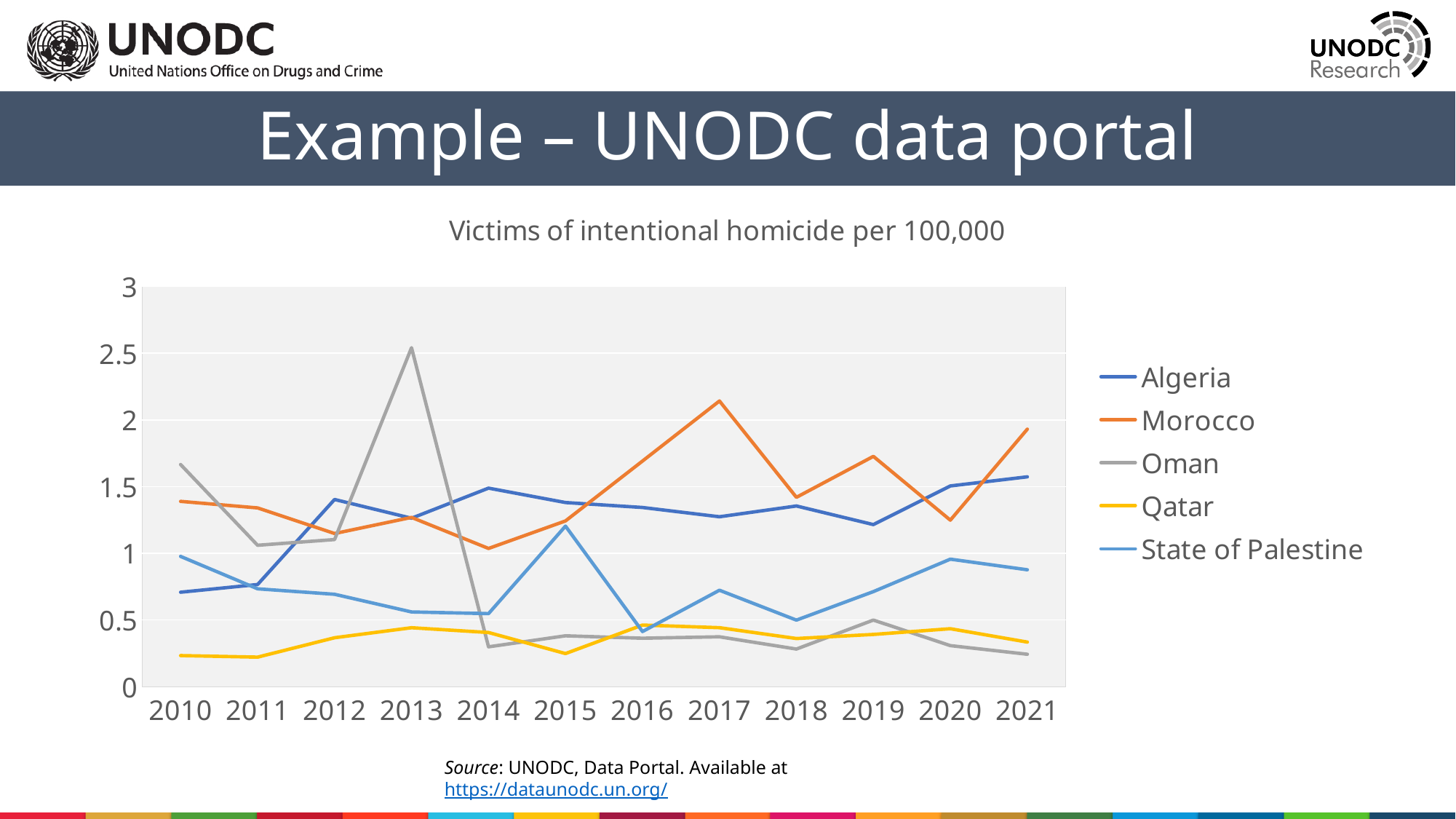
What kind of chart is shown on the slide? line chart How many years are shown on the x axis? 12 Is the value for Oman in 2013 greater or less than 2? greater Is the value for Qatar in 2010 greater or less than 0.5? less In 2021, which is higher, Morocco or Algeria? Morocco Does the value for Oman rise or fall from 2013 to 2014? fall Which country has the lowest value in 2010? Qatar Which country has the highest value in 2017? Morocco How many series does the legend list? 5 Which country has the highest value in 2013? Oman What is the title of the chart? Victims of intentional homicide per 100,000 In 2015, which is higher, State of Palestine or Qatar? State of Palestine